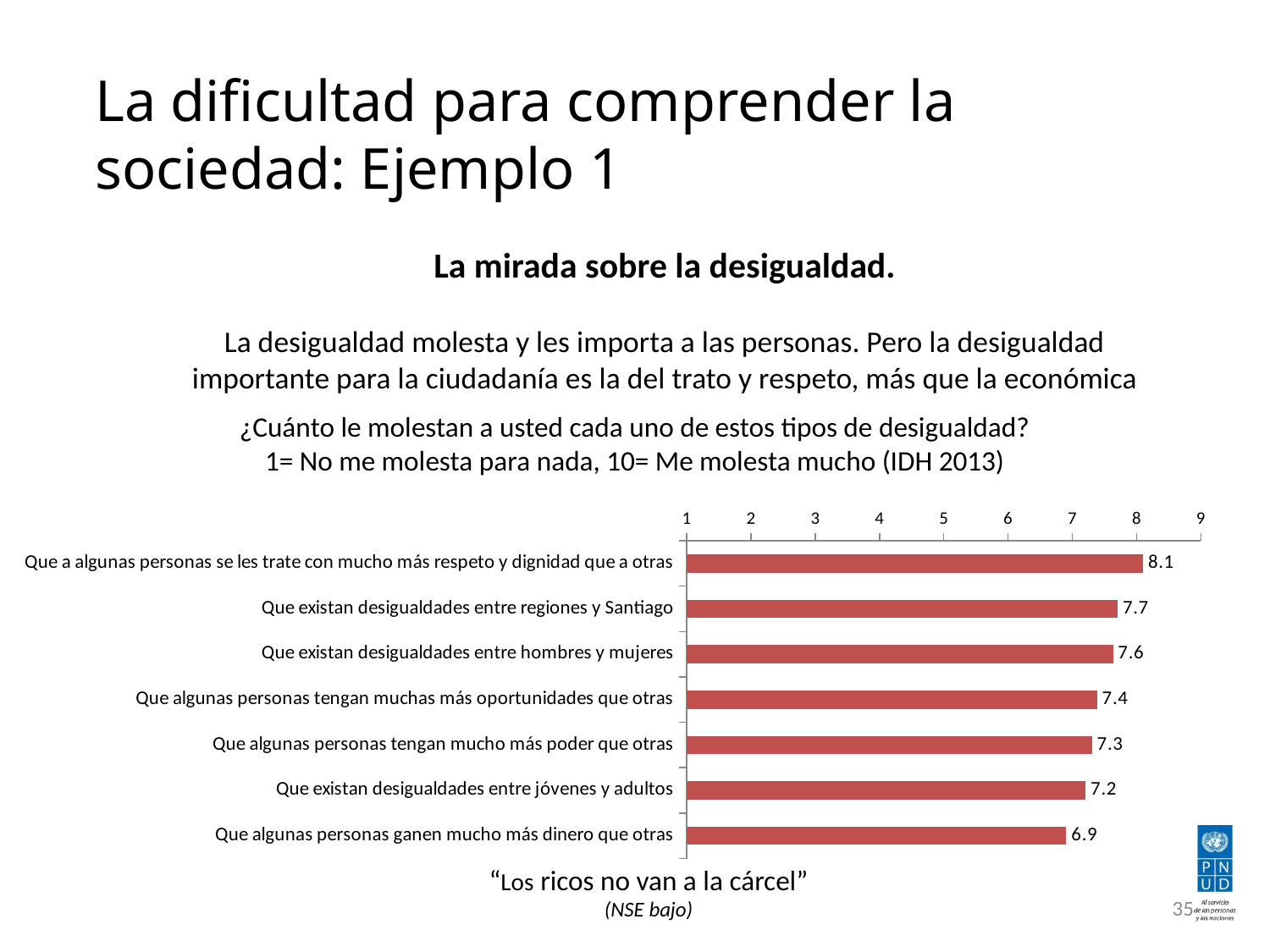
Which is larger: the value for "Que existan desigualdades entre regiones y Santiago" or the value for "Que existan desigualdades entre jóvenes y adultos"? Que existan desigualdades entre regiones y Santiago What is the value for "Que algunas personas tengan muchas más oportunidades que otras"? 7.4 What kind of chart is shown on the slide? bar chart How many categories are shown in the chart? 7 What is the value for "Que existan desigualdades entre hombres y mujeres"? 7.6 What is the highest value shown on the chart's axis? 9 Which category has the highest value? Que a algunas personas se les trate con mucho más respeto y dignidad que a otras Is the value for "Que algunas personas tengan mucho más poder que otras" greater or less than 7? greater What is the difference between the value for "Que a algunas personas se les trate con mucho más respeto y dignidad que a otras" and the value for "Que algunas personas ganen mucho más dinero que otras"? 1.2 Which category has the lowest value? Que algunas personas ganen mucho más dinero que otras What is the value for "Que algunas personas ganen mucho más dinero que otras"? 6.9 What is the value for "Que a algunas personas se les trate con mucho más respeto y dignidad que a otras"? 8.1